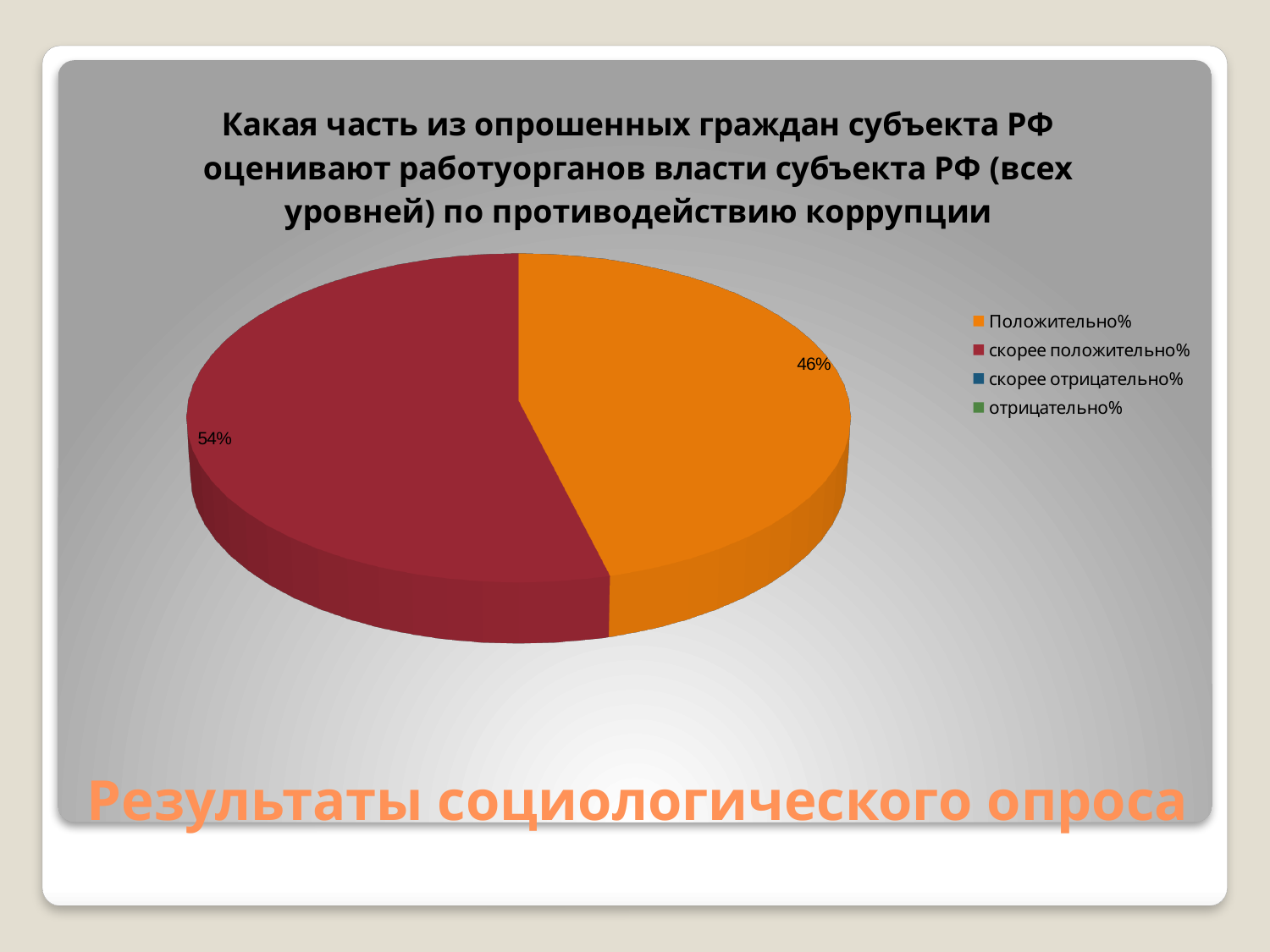
What percentage of the pie is labelled for the "скорее положительно%" slice? 54% How many entries does the chart legend list? 4 Which of the two labelled slices is the smaller one? Положительно% Which is larger: the "Положительно%" slice or the "скорее положительно%" slice? скорее положительно% What colour is the "Положительно%" slice in the pie chart? Orange What is the difference in percentage points between the "скорее положительно%" slice and the "Положительно%" slice? 8% What colour does the legend assign to "скорее отрицательно%"? Blue Which slice of the pie chart is the largest? скорее положительно% What percentage of the pie is labelled for the "Положительно%" slice? 46% How many slices with data labels are visible in the pie chart? 2 What kind of chart is shown on the slide? Pie chart